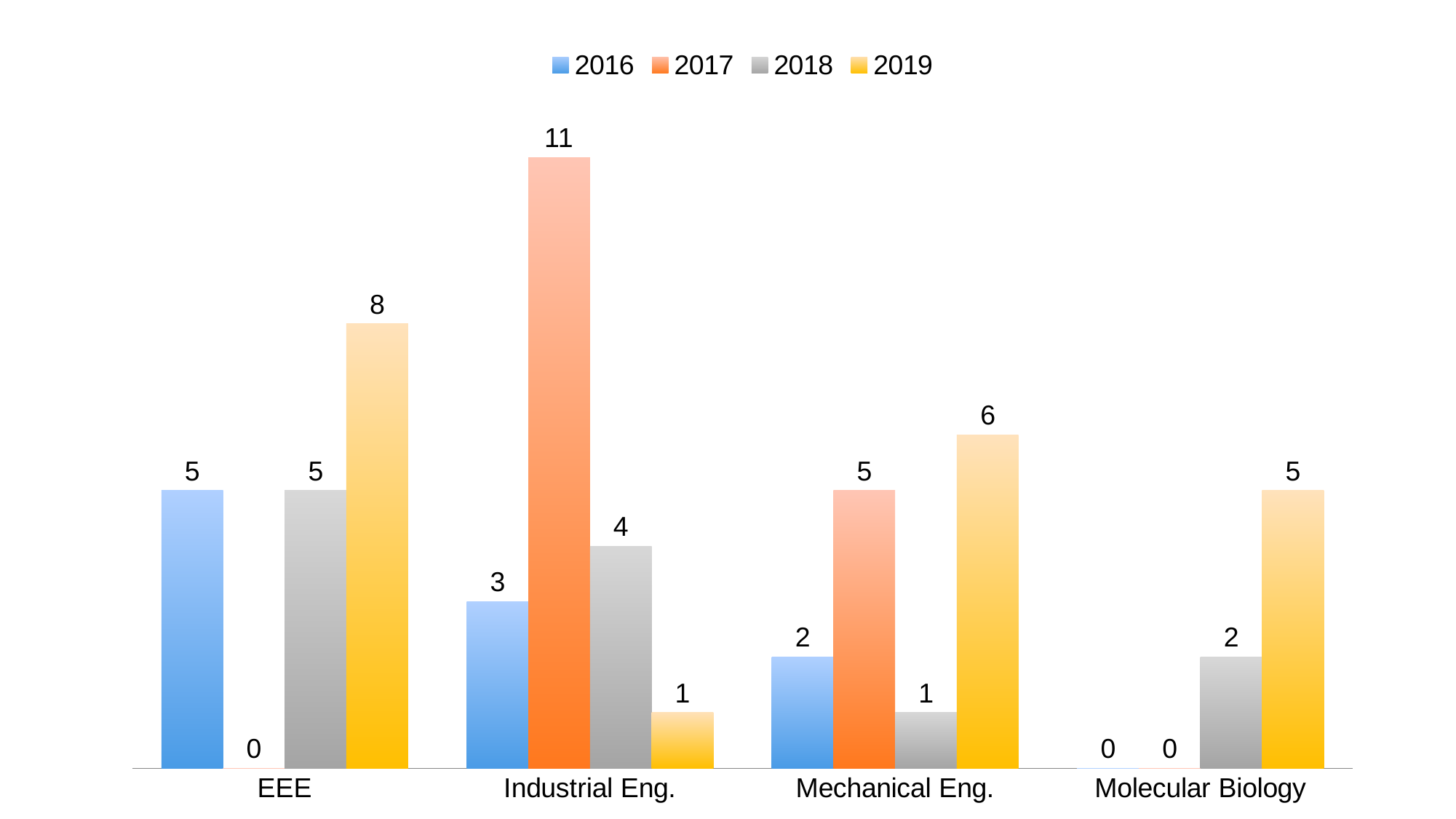
Which category has the highest value in 2017? Industrial Eng. What is the value for EEE in 2019? 8 What is the difference between the 2017 and 2018 values for Industrial Eng.? 7 Which category has the lowest value in 2019? Industrial Eng. What kind of chart is shown on the slide? Bar chart What is the value for Industrial Eng. in 2017? 11 What is the value for Mechanical Eng. in 2016? 2 How many categories are shown on the x axis? 4 Which is larger for Mechanical Eng., the 2017 value or the 2019 value? 2019 How many series does the legend list? 4 What is the value for Molecular Biology in 2018? 2 Which colour represents the 2018 series in the legend? Grey